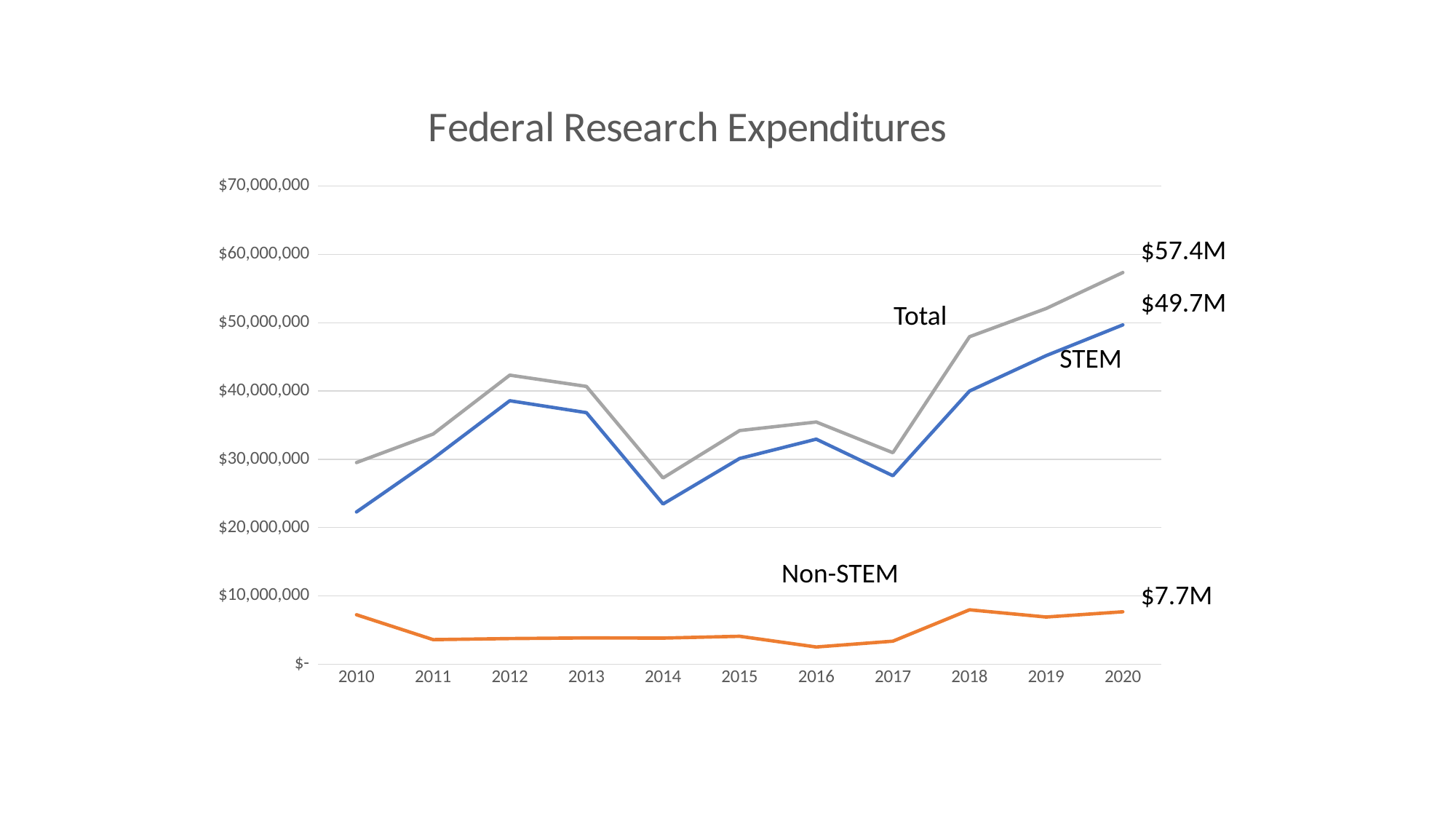
Is the value of the STEM series in 2014 greater or less than $30,000,000? less What is the value of the STEM series in 2020? $49.7M What kind of chart is shown on the slide? line chart What is the value of the Non-STEM series in 2020? $7.7M What is the title of the chart? Federal Research Expenditures What is the difference between the Total and STEM values in 2020? $7.7M In which year is the Total series lowest? 2014 What is the value of the Total series in 2020? $57.4M How many years are shown on the x axis? 11 Which is larger, the STEM value in 2016 or the STEM value in 2017? 2016 How many series are plotted on the chart? 3 In which year is the Total series highest? 2020